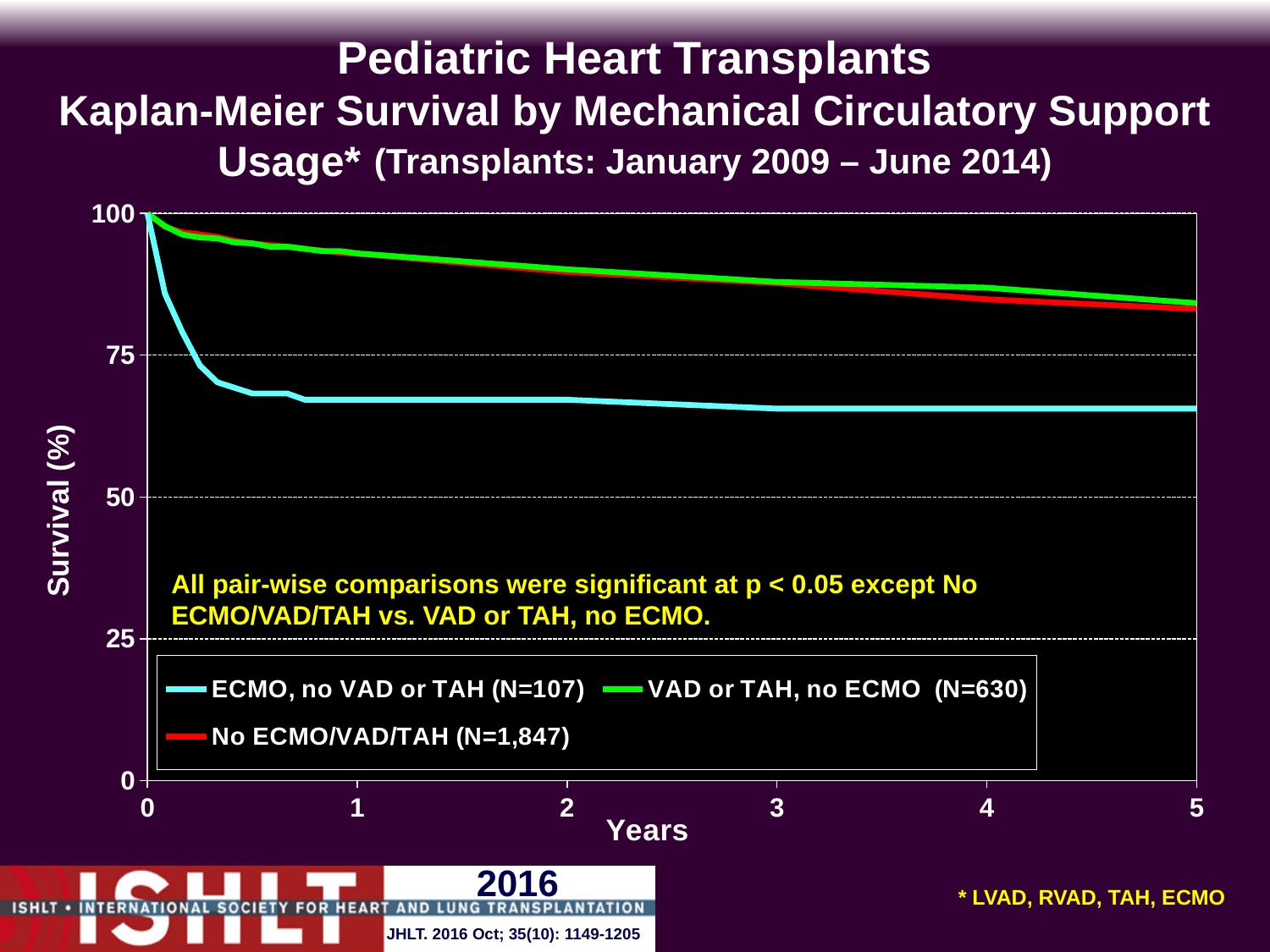
How many series does the legend list? 3 What is the highest value shown on the y axis? 100 Is the survival value for ECMO, no VAD or TAH at 5 years greater or less than 75? less Do the survival curves rise or fall as years increase? fall What is the N shown in the legend for the ECMO, no VAD or TAH group? N=107 Is the survival value for VAD or TAH, no ECMO at 5 years greater or less than 75? greater Which series has the lowest survival at 5 years? ECMO, no VAD or TAH At 3 years, which series has higher survival: ECMO, no VAD or TAH or VAD or TAH, no ECMO? VAD or TAH, no ECMO Is the survival value for ECMO, no VAD or TAH at 5 years greater or less than 50? greater What kind of chart is shown on the slide? line chart What is the label of the y axis? Survival (%)